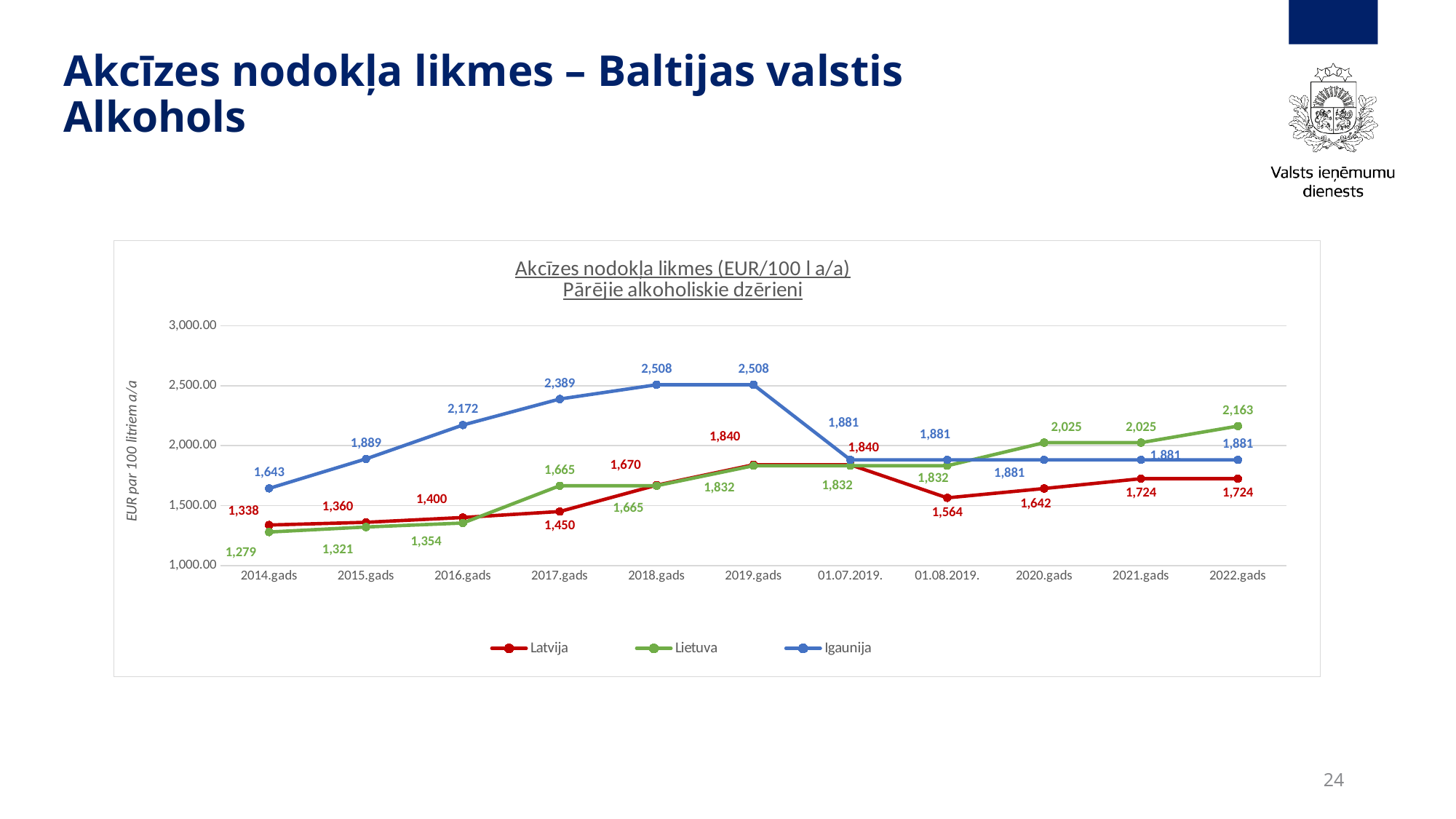
Does the Igaunija series rise or fall from 2014.gads to 2018.gads? rise What is the value for Igaunija in 2018.gads? 2,508 What is the difference between the Igaunija and Latvija values in 2019.gads? 668 Which series has the highest value in 2017.gads? Igaunija What is the value for Lietuva in 2022.gads? 2,163 Which series has the lowest value in 2016.gads? Lietuva What type of chart is shown on the slide? line chart How many series does the legend list? 3 In 2022.gads, which is larger: the value for Lietuva or the value for Igaunija? Lietuva How many points are plotted along the x axis for each series? 11 What is the value for Latvija in 2014.gads? 1,338 What is the label of the vertical axis? EUR par 100 litriem a/a